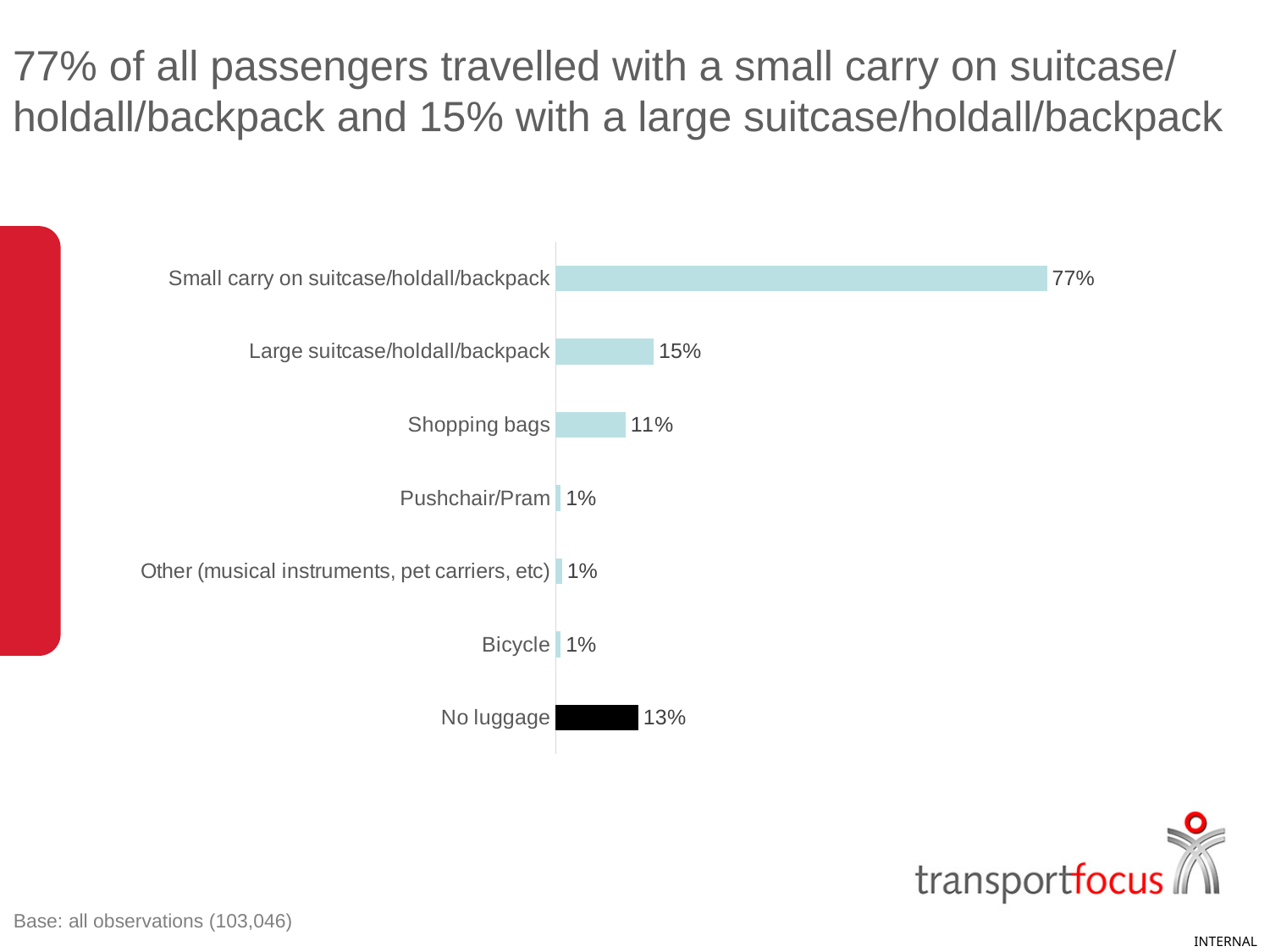
What is the value shown for No luggage? 13% What is the difference between the values for No luggage and Shopping bags? 2% What is the value shown for Shopping bags? 11% How many categories are shown in the chart? 7 Which category has the highest value? Small carry on suitcase/holdall/backpack Which is larger, the value for Large suitcase/holdall/backpack or the value for No luggage? Large suitcase/holdall/backpack What is the value shown for Bicycle? 1% Which bar is coloured black rather than light blue? No luggage What percentage of passengers travelled with a small carry on suitcase/holdall/backpack? 77% How many categories have a value of 1%? 3 What kind of chart is shown on the slide? Bar chart What is the difference between the values for Small carry on suitcase/holdall/backpack and Large suitcase/holdall/backpack? 62%